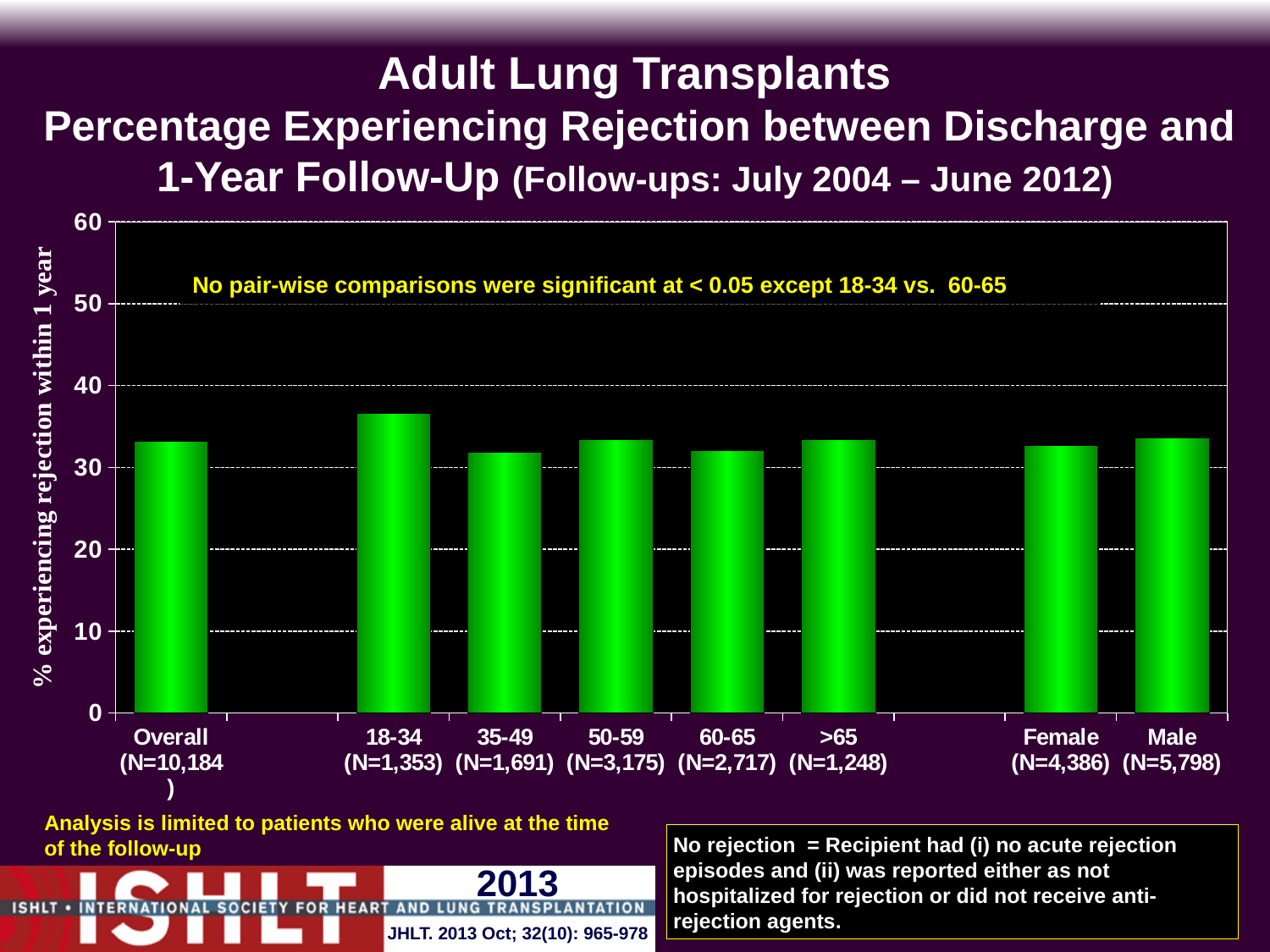
Which category has the highest percentage experiencing rejection within 1 year? 18-34 Is the value for the 18-34 age group greater or less than 40? less Is the value for Female greater or less than 40? less What is the label of the y-axis? % experiencing rejection within 1 year According to the note on the chart, which pair-wise comparison was significant at < 0.05? 18-34 vs. 60-65 How many bars (categories) are plotted in the chart? 8 Is the value for the 60-65 age group greater or less than 20? greater Which is larger, the value for the 18-34 age group or the value for the 60-65 age group? 18-34 Which is larger, the value for the 18-34 age group or the value for the 35-49 age group? 18-34 What kind of chart is shown on the slide? bar chart